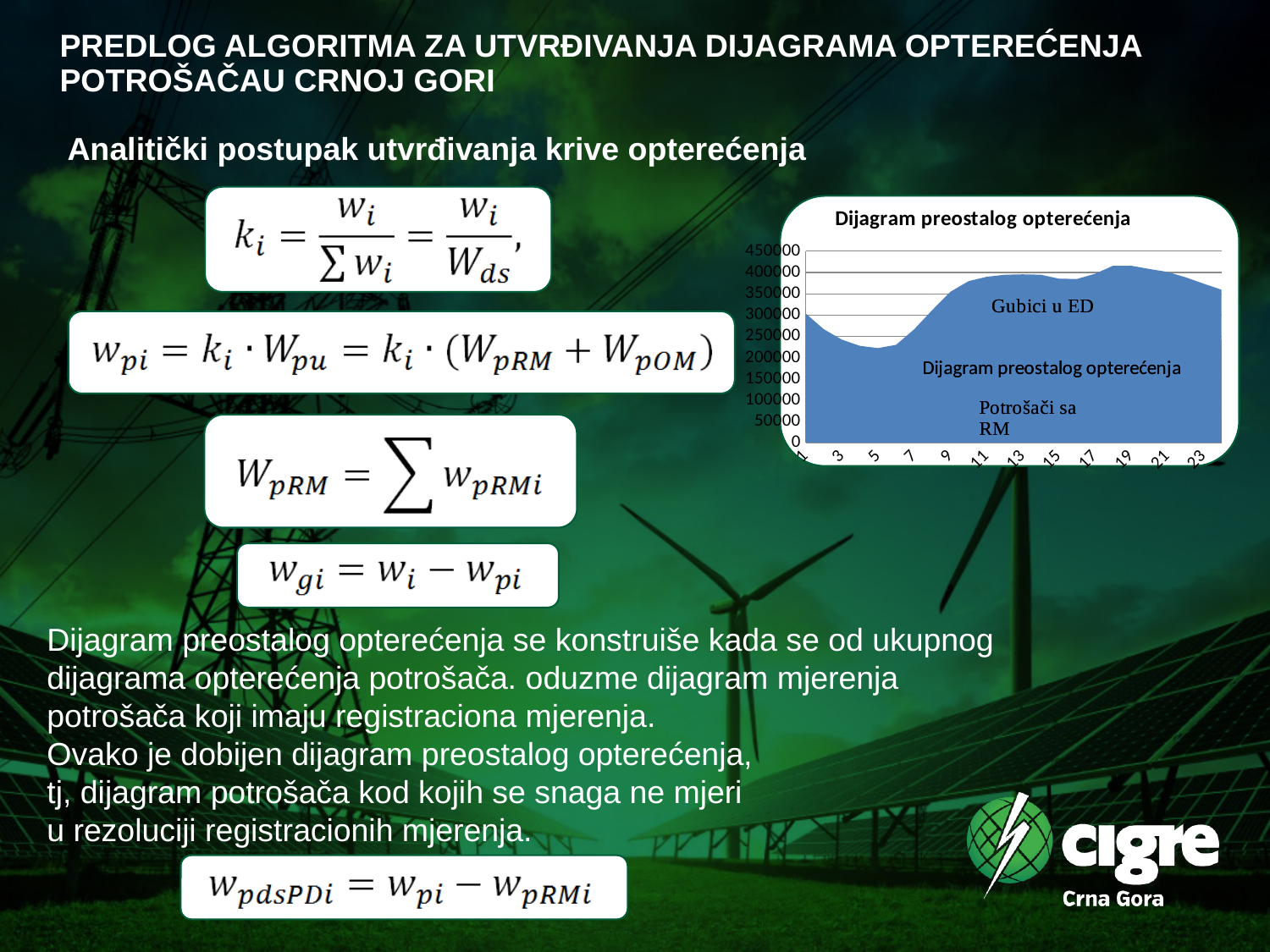
Is the value at x = 3 greater or less than 300000? less What is the highest value shown on the y axis of the chart? 450000 Do the values rise or fall between x = 5 and x = 11? rise What kind of chart is shown on the slide? area chart Do the values rise or fall between x = 1 and x = 5? fall Which is larger, the value at x = 3 or the value at x = 13? x = 13 Is the value at x = 13 greater or less than 350000? greater How many labels are printed on the x axis of the chart? 12 Is the value at x = 11 greater or less than 300000? greater Which is larger, the value at x = 19 or the value at x = 5? x = 19 What is the title of the chart on the slide? Dijagram preostalog opterećenja